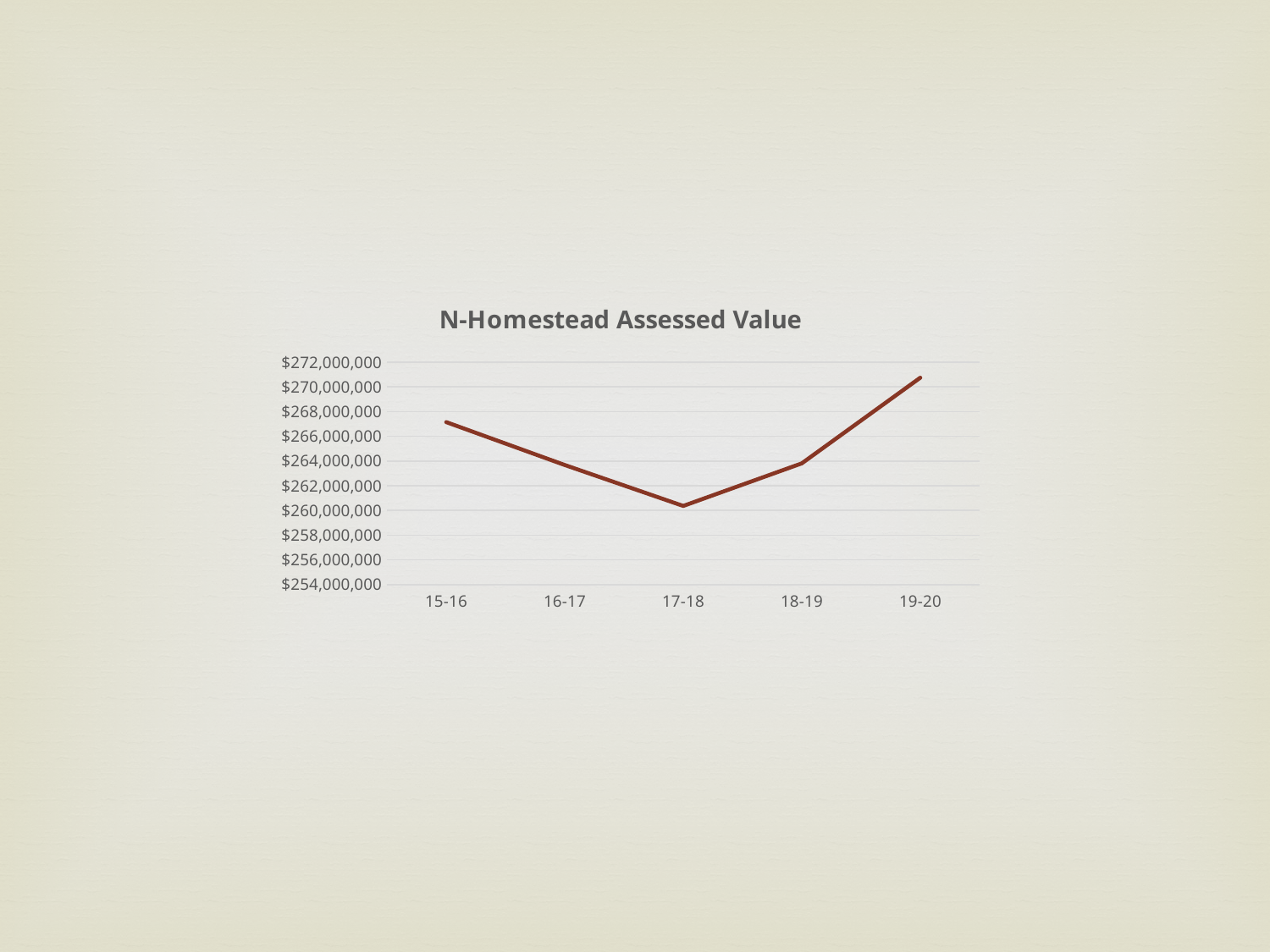
Which is larger, the value for 15-16 or the value for 19-20? 19-20 Is the value for 16-17 greater or less than $262,000,000? greater Which year has the lowest N-Homestead Assessed Value? 17-18 Is the value for 15-16 greater or less than $266,000,000? greater How many years are plotted on the x axis of the chart? 5 What is the title of the chart? N-Homestead Assessed Value Which year has the highest N-Homestead Assessed Value? 19-20 Is the value for 17-18 greater or less than $262,000,000? less How does the N-Homestead Assessed Value change from 15-16 to 19-20? falls until 17-18, then rises Which is larger, the value for 15-16 or the value for 16-17? 15-16 What kind of chart is shown on the slide? line chart